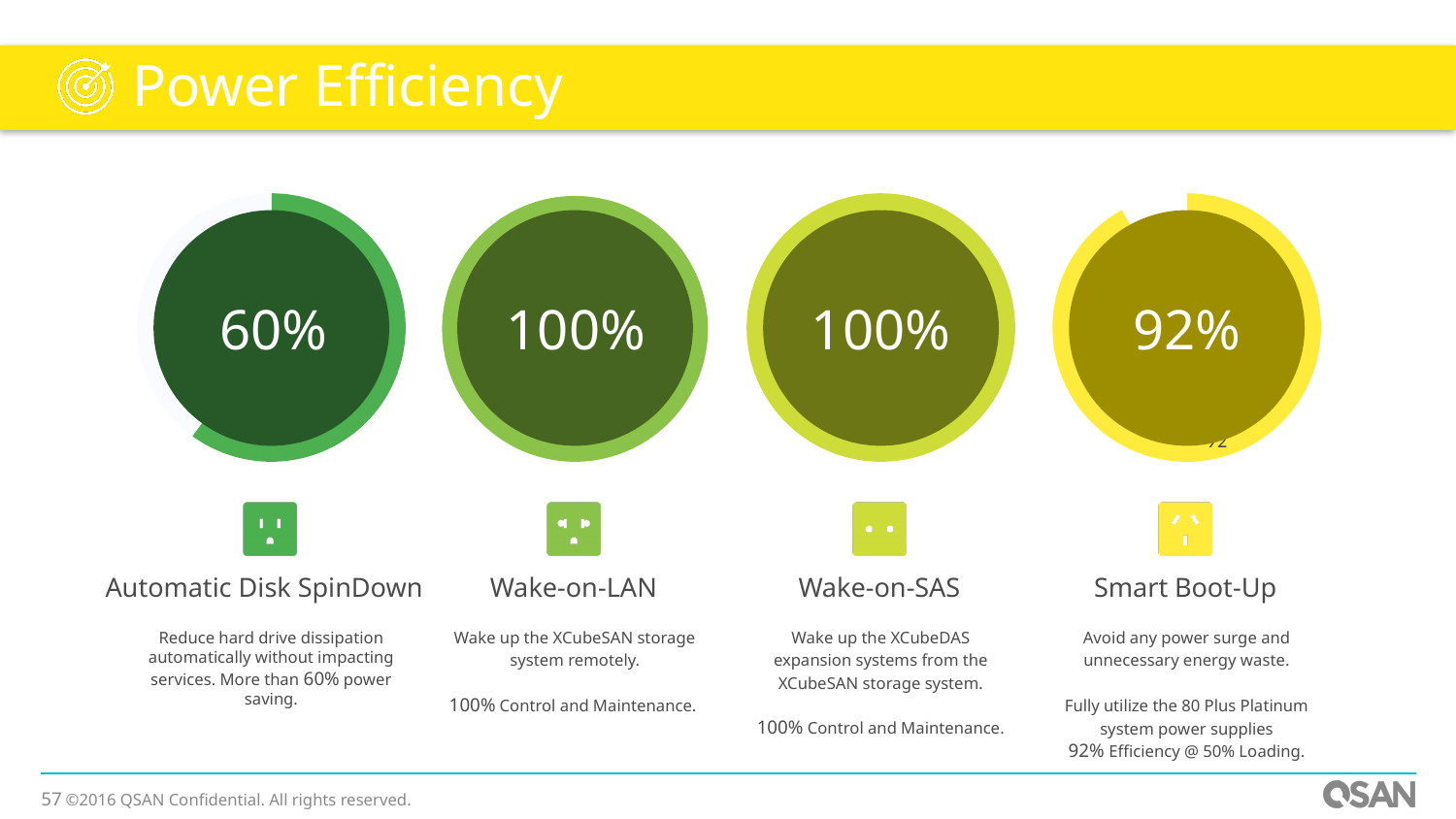
What percentage is shown in the Wake-on-SAS ring chart? 100% What percentage is shown in the Automatic Disk SpinDown ring chart? 60% What colour is the ring of the Smart Boot-Up chart? Yellow What percentage is shown in the Wake-on-LAN ring chart? 100% What kind of chart is used to display each percentage on the slide? Doughnut (ring) chart Which of the four ring charts shows the lowest percentage? Automatic Disk SpinDown What is the difference between the Smart Boot-Up percentage and the Automatic Disk SpinDown percentage? 32% Which is larger, the Wake-on-LAN percentage or the Smart Boot-Up percentage? Wake-on-LAN What is the difference between the Wake-on-SAS percentage and the Smart Boot-Up percentage? 8% How many ring charts are shown on the slide? 4 What is the title of the slide containing the four ring charts? Power Efficiency What percentage is shown in the Smart Boot-Up ring chart? 92%